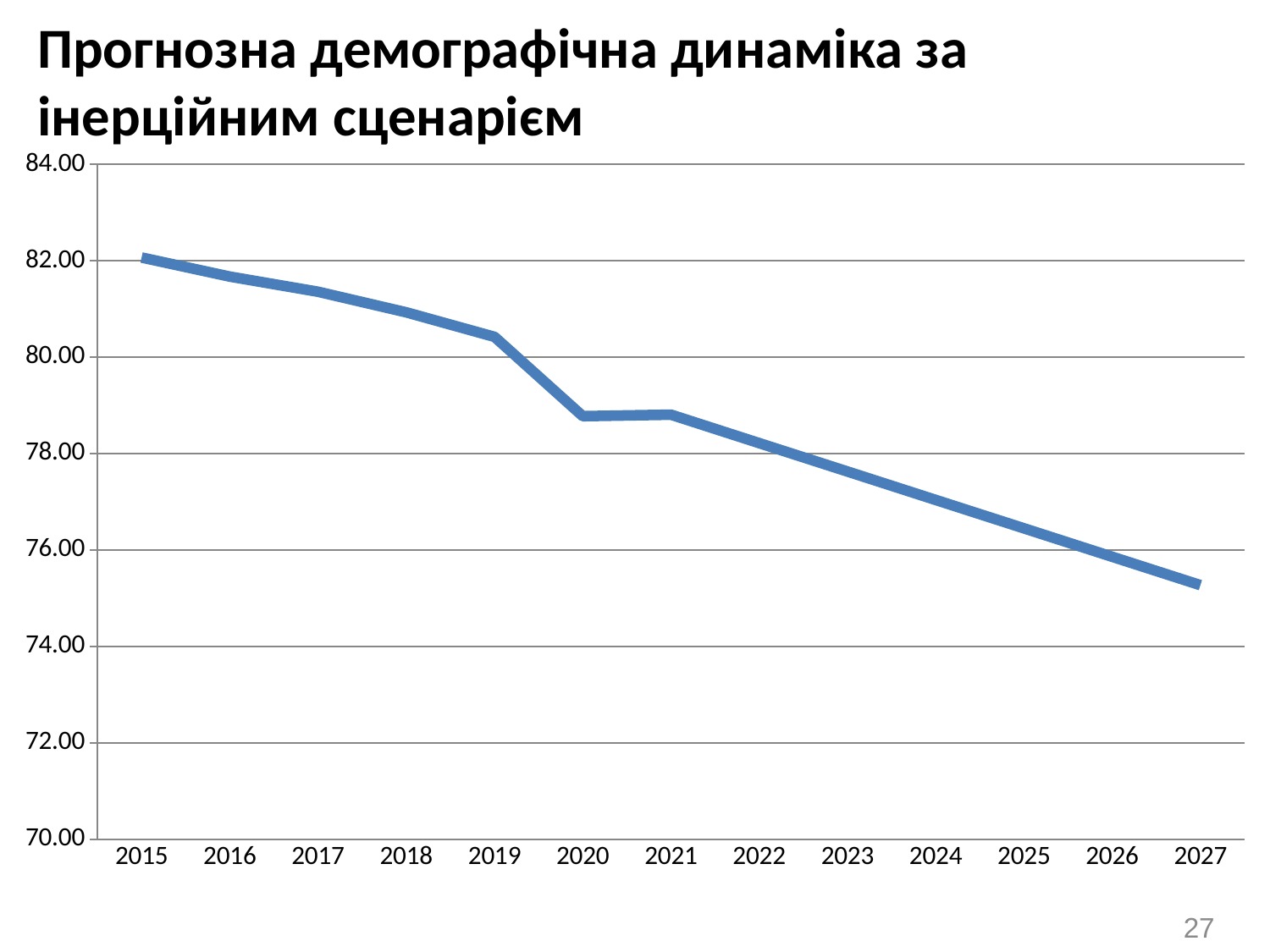
Is the value for 2017 greater or less than 80.00? greater How many years are plotted along the x axis? 13 Which year has the highest value on the chart? 2015 Is the value for 2027 greater or less than 76.00? less Which year has the larger value, 2015 or 2027? 2015 What is the title of the chart on the slide? Прогнозна демографічна динаміка за інерційним сценарієм Is the value for 2020 greater or less than 80.00? less Which year has the lowest value on the chart? 2027 What kind of chart is shown on the slide? line chart Do the values rise or fall from 2015 to 2027? fall